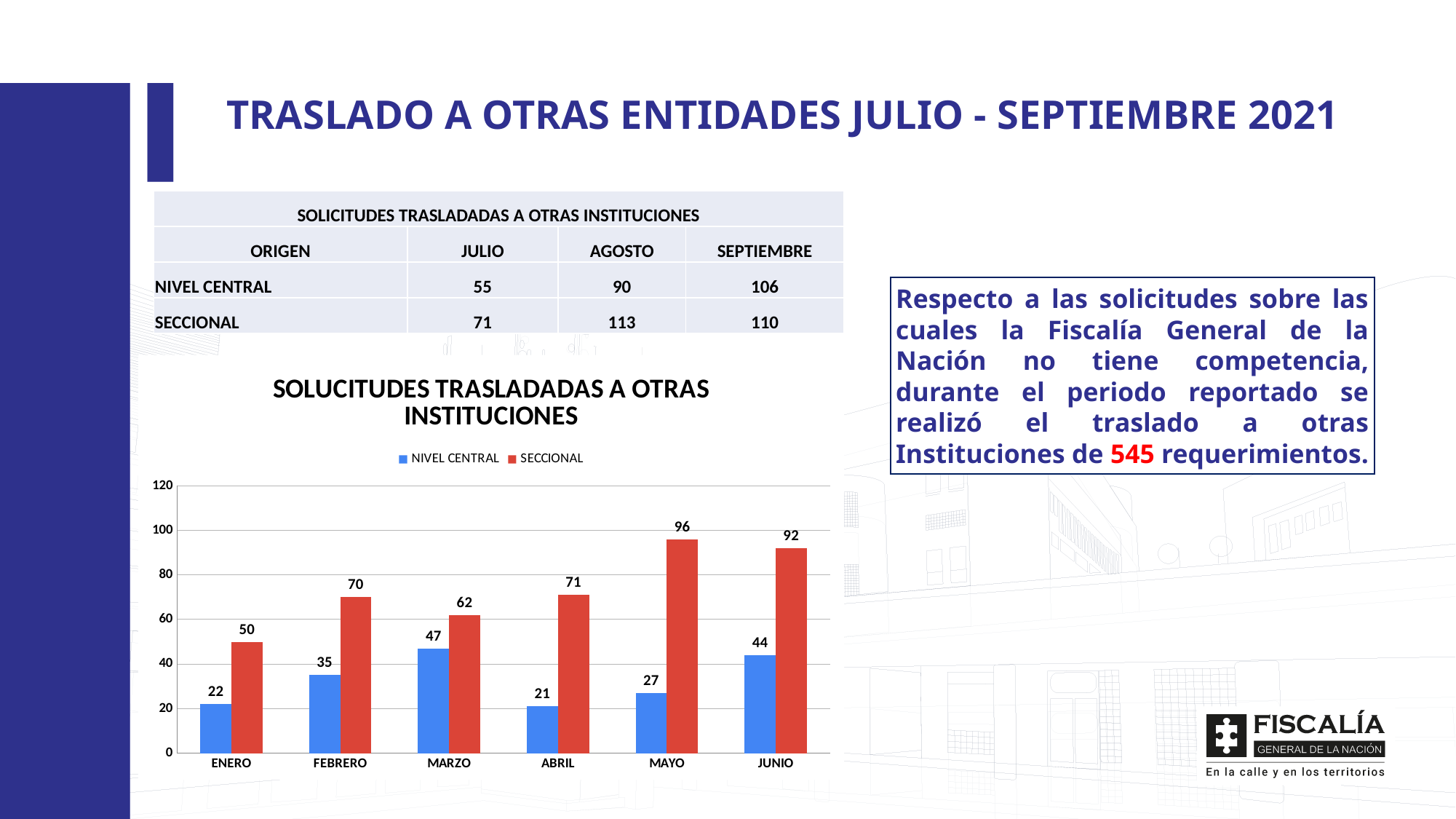
Which month has the lowest NIVEL CENTRAL value in the chart? ABRIL What kind of chart is shown on the slide? bar chart What is the SECCIONAL value for MAYO in the chart? 96 What colour are the SECCIONAL bars in the chart? red How many series does the chart legend list? 2 What is the SECCIONAL value for ENERO in the chart? 50 In the chart, which is larger for FEBRERO: NIVEL CENTRAL or SECCIONAL? SECCIONAL What is the NIVEL CENTRAL value for MARZO in the chart? 47 How many months are shown on the x axis of the chart? 6 Which month has the highest SECCIONAL value in the chart? MAYO What is the difference between the SECCIONAL and NIVEL CENTRAL values for JUNIO in the chart? 48 Is the SECCIONAL value for ABRIL greater or less than 60 in the chart? greater